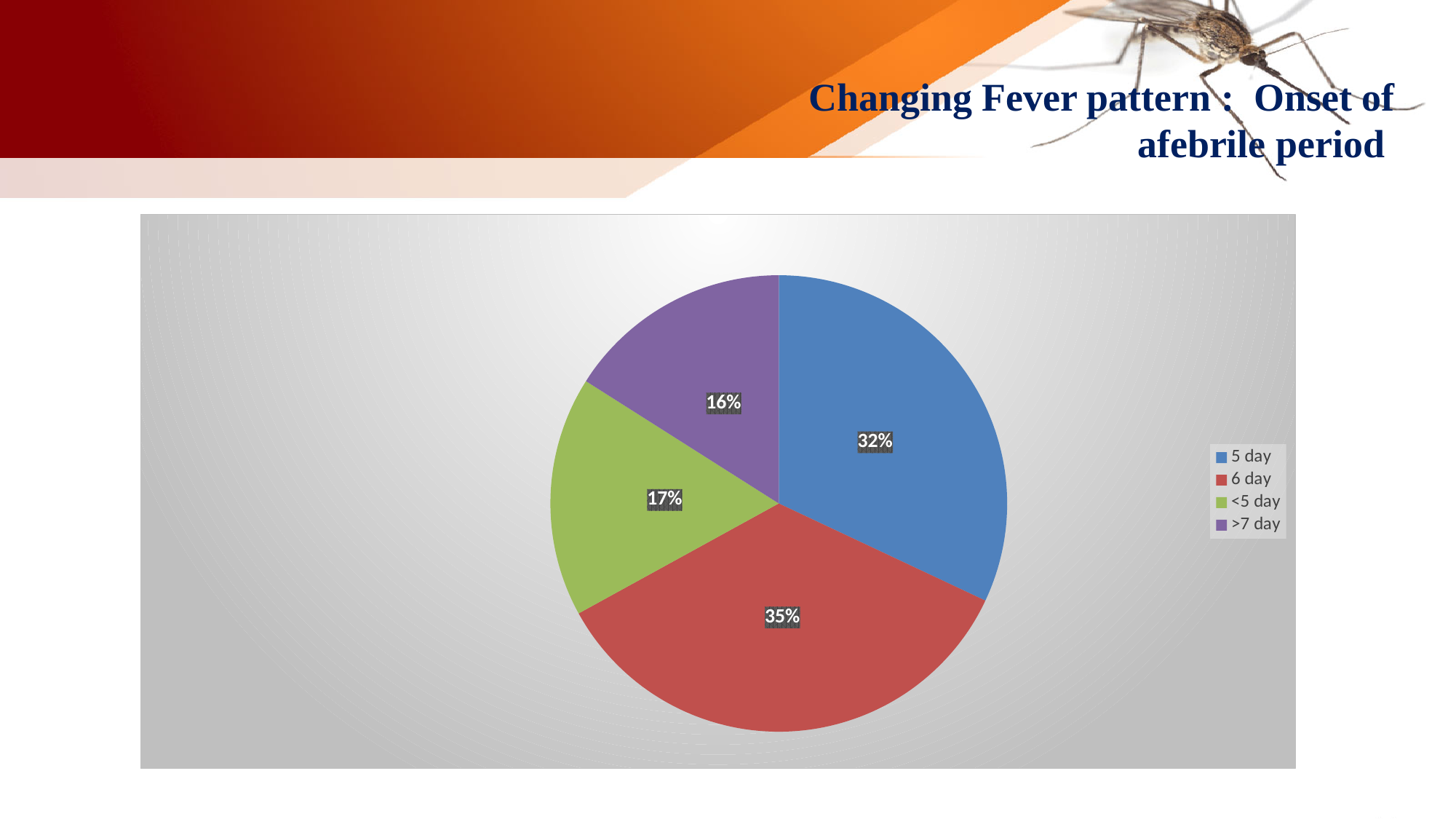
What kind of chart is shown on the slide? pie chart Which category has the smallest share of the pie? >7 day What percentage of the pie is the 6 day slice? 35% Which category has the largest share of the pie? 6 day How many categories does the legend list? 4 What is the difference in percentage points between the 5 day slice and the >7 day slice? 16 What percentage of the pie is the 5 day slice? 32% What colour is the 6 day slice? red What is the difference in percentage points between the 6 day slice and the 5 day slice? 3 Which is larger, the 5 day slice or the <5 day slice? 5 day What percentage of the pie is the >7 day slice? 16% What percentage of the pie is the <5 day slice? 17%